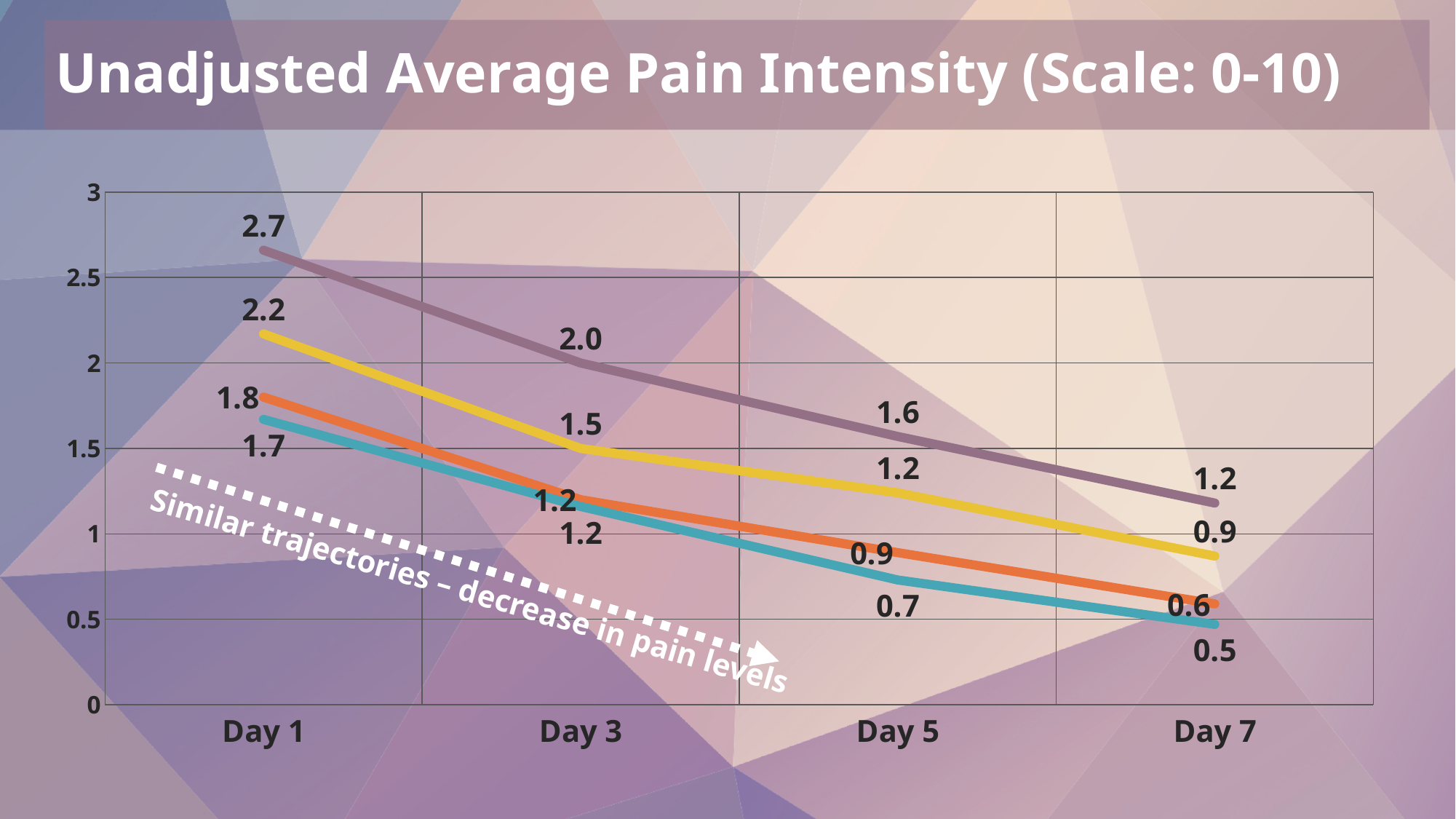
What is the value of the orange line on Day 5? 0.9 Which day has the lowest value for the yellow line? Day 7 What is the difference between the purple line's value on Day 1 and its value on Day 7? 1.5 What kind of chart is shown on the slide? Line chart Do the values of the lines rise or fall from Day 1 to Day 7? Fall What is the title of the chart? Unadjusted Average Pain Intensity (Scale: 0-10) What is the value of the teal line on Day 7? 0.5 Which day has the highest value for the purple line? Day 1 Which is larger on Day 5: the purple line's value or the yellow line's value? The purple line's value What is the value of the yellow line on Day 3? 1.5 How many points are on the x axis of the chart? 4 What is the value of the purple line on Day 1? 2.7